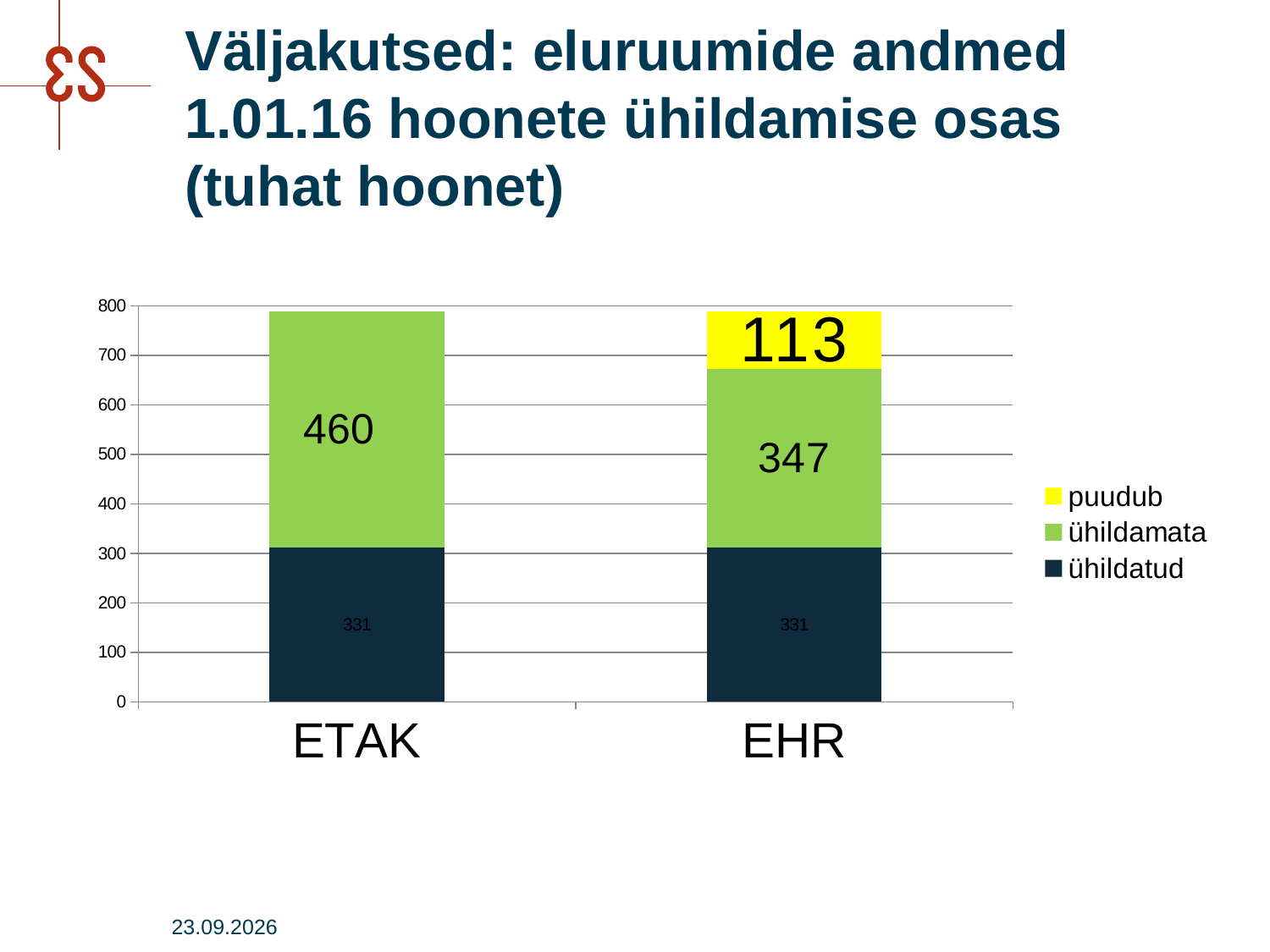
What is the value of ühildamata for ETAK? 460 How many categories are shown on the x axis? 2 Which series is shown in yellow in the legend? puudub Which category has the larger ühildamata value, ETAK or EHR? ETAK What is the value of ühildamata for EHR? 347 What is the total of the stacked bar for EHR? 791 What is the total of the stacked bar for ETAK? 791 How many series does the legend list? 3 What is the value of ühildatud for ETAK? 331 What kind of chart is shown on the slide? Stacked bar chart What is the difference between the ühildamata values for ETAK and EHR? 113 What is the value of puudub for EHR? 113